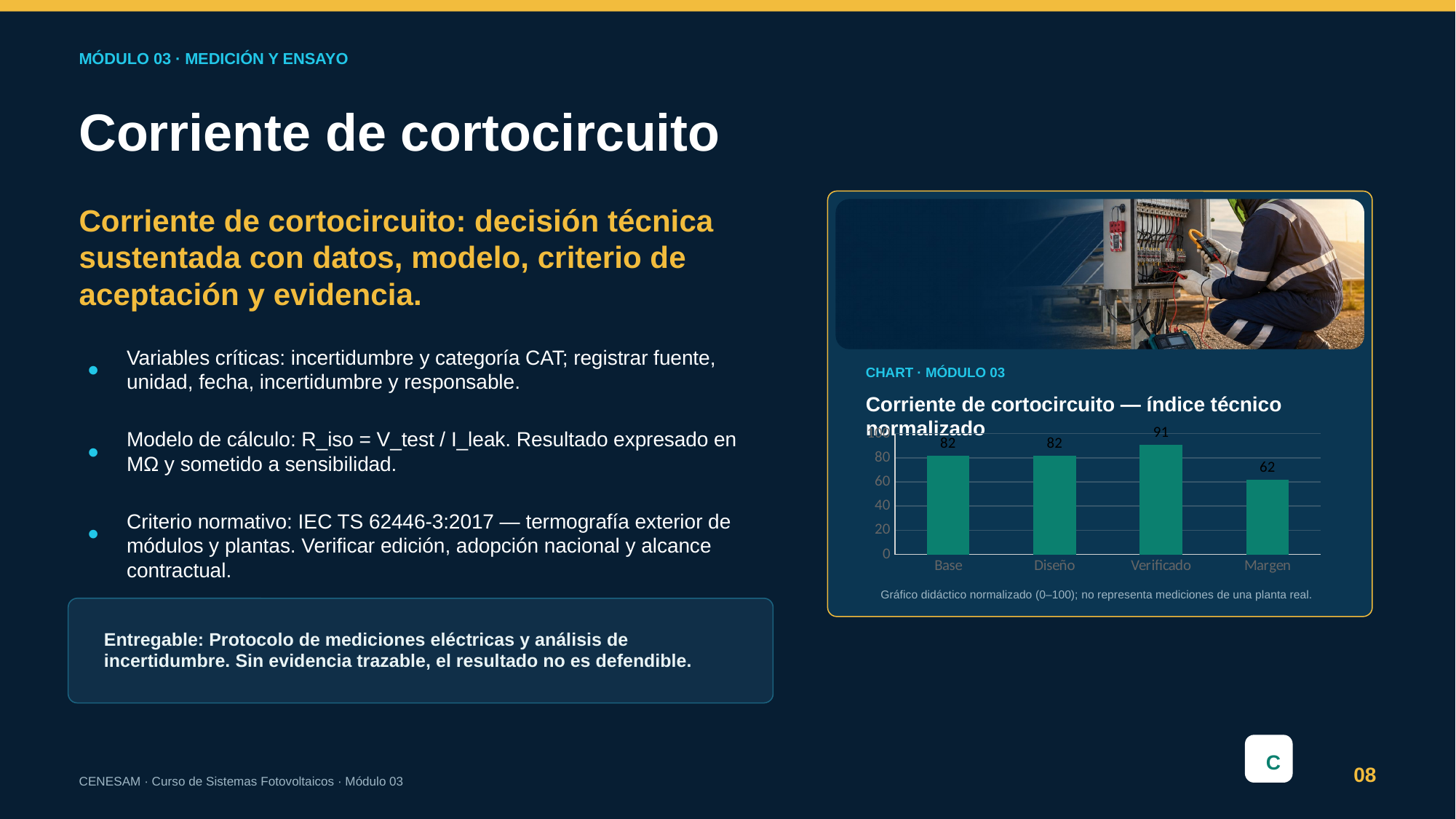
What is the value for Margen? 62 What kind of chart is shown on the slide? bar chart Which category has the highest value? Verificado Which is larger, the value for Diseño or the value for Margen? Diseño Which category has the lowest value? Margen Is the value for Margen greater or less than 80? less What is the title of the chart? Corriente de cortocircuito — índice técnico normalizado How many categories are shown on the x axis? 4 What is the difference between the values for Verificado and Diseño? 9 What is the value for Base? 82 What is the difference between the values for Verificado and Margen? 29 What is the value for Verificado? 91